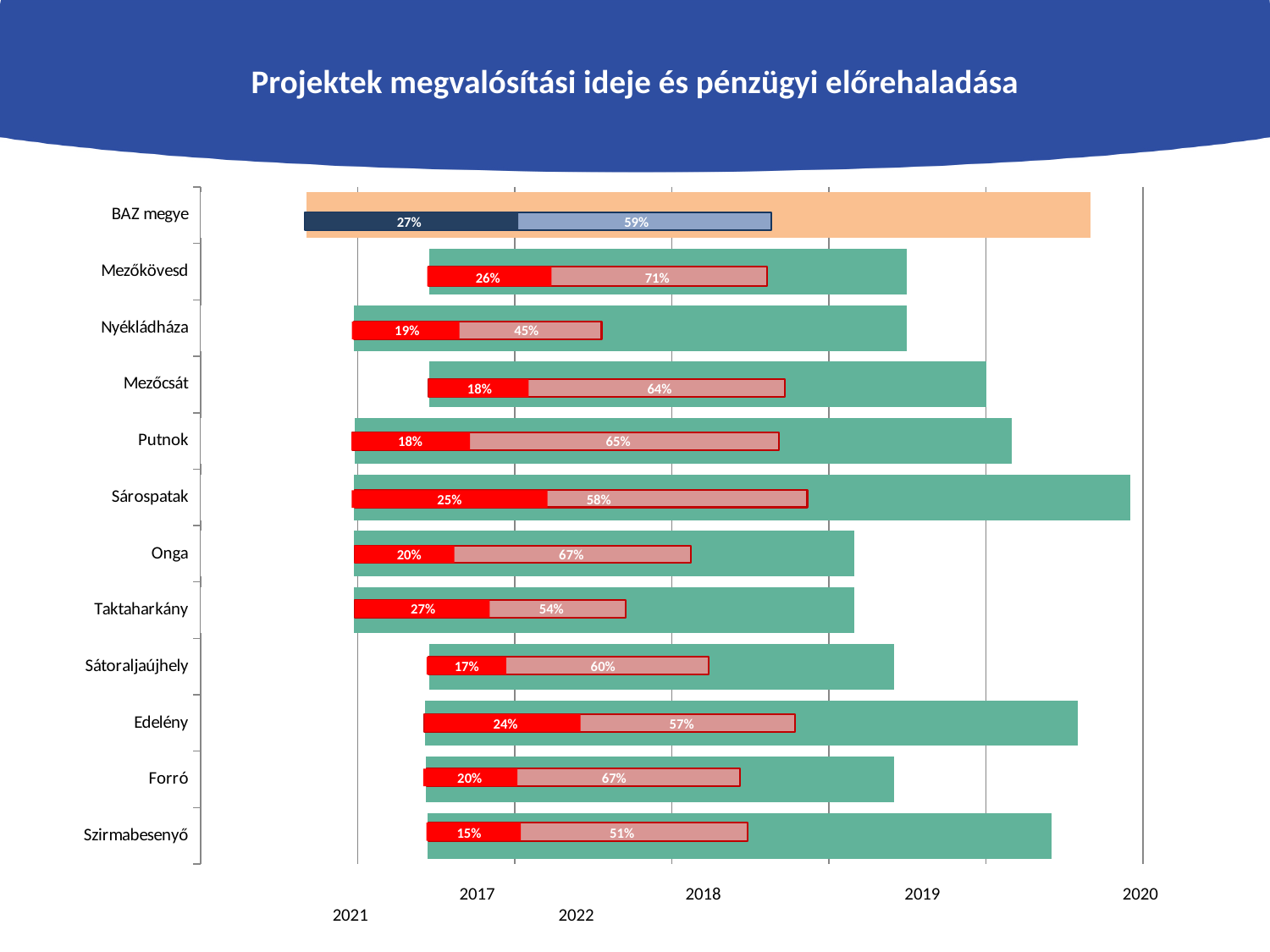
Which is larger: the second percentage label for Onga or for Taktaharkány? Onga Which category has the lowest second (light red) percentage label? Nyékládháza Which category has the lowest first (dark red) percentage label? Szirmabesenyő What is the difference between the second and first percentage labels for Mezőkövesd? 45% What is the first percentage label shown for Szirmabesenyő? 15% What is the first (dark red) percentage label shown for Mezőkövesd? 26% What is the title of the slide? Projektek megvalósítási ideje és pénzügyi előrehaladása What kind of chart is shown on the slide? Bar chart Which category has the highest second (light red) percentage label? Mezőkövesd What is the second percentage label shown for Sárospatak? 58% What is the second (light red) percentage label shown for Nyékládháza? 45% How many categories are listed on the vertical axis of the chart? 12